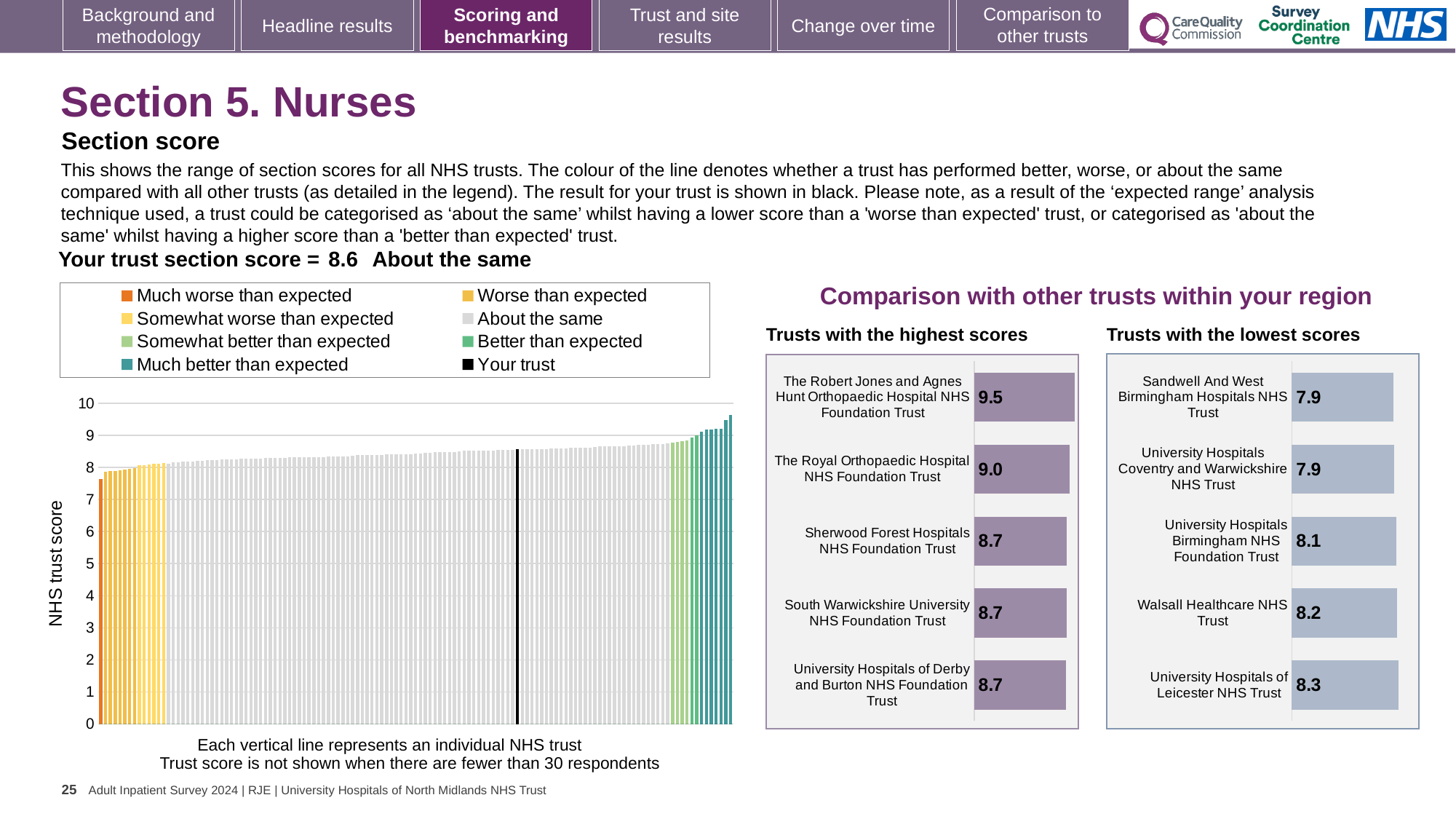
In the 'Trusts with the highest scores' chart, what is the difference between the scores of The Robert Jones and Agnes Hunt Orthopaedic Hospital NHS Foundation Trust and The Royal Orthopaedic Hospital NHS Foundation Trust? 0.5 In the main NHS trust score chart on the left, is the value for the black 'Your trust' bar greater or less than 8? greater In the 'Trusts with the lowest scores' chart, which trust has the highest score? University Hospitals of Leicester NHS Trust In the main NHS trust score chart on the left, do the trust scores rise or fall from left to right along the x axis? Rise In the 'Trusts with the highest scores' chart, how many trusts are shown? 5 In the 'Trusts with the highest scores' chart, what is the score for The Royal Orthopaedic Hospital NHS Foundation Trust? 9.0 In the 'Trusts with the lowest scores' chart, which has the larger score: Walsall Healthcare NHS Trust or University Hospitals Birmingham NHS Foundation Trust? Walsall Healthcare NHS Trust What kind of chart is the main NHS trust score chart on the left? Bar chart In the main NHS trust score chart on the left, how many entries does the legend list? 8 In the 'Trusts with the lowest scores' chart, what is the score for Walsall Healthcare NHS Trust? 8.2 In the 'Trusts with the highest scores' chart, what is the score for The Robert Jones and Agnes Hunt Orthopaedic Hospital NHS Foundation Trust? 9.5 In the 'Trusts with the lowest scores' chart, what is the difference between the scores of University Hospitals of Leicester NHS Trust and Sandwell And West Birmingham Hospitals NHS Trust? 0.4